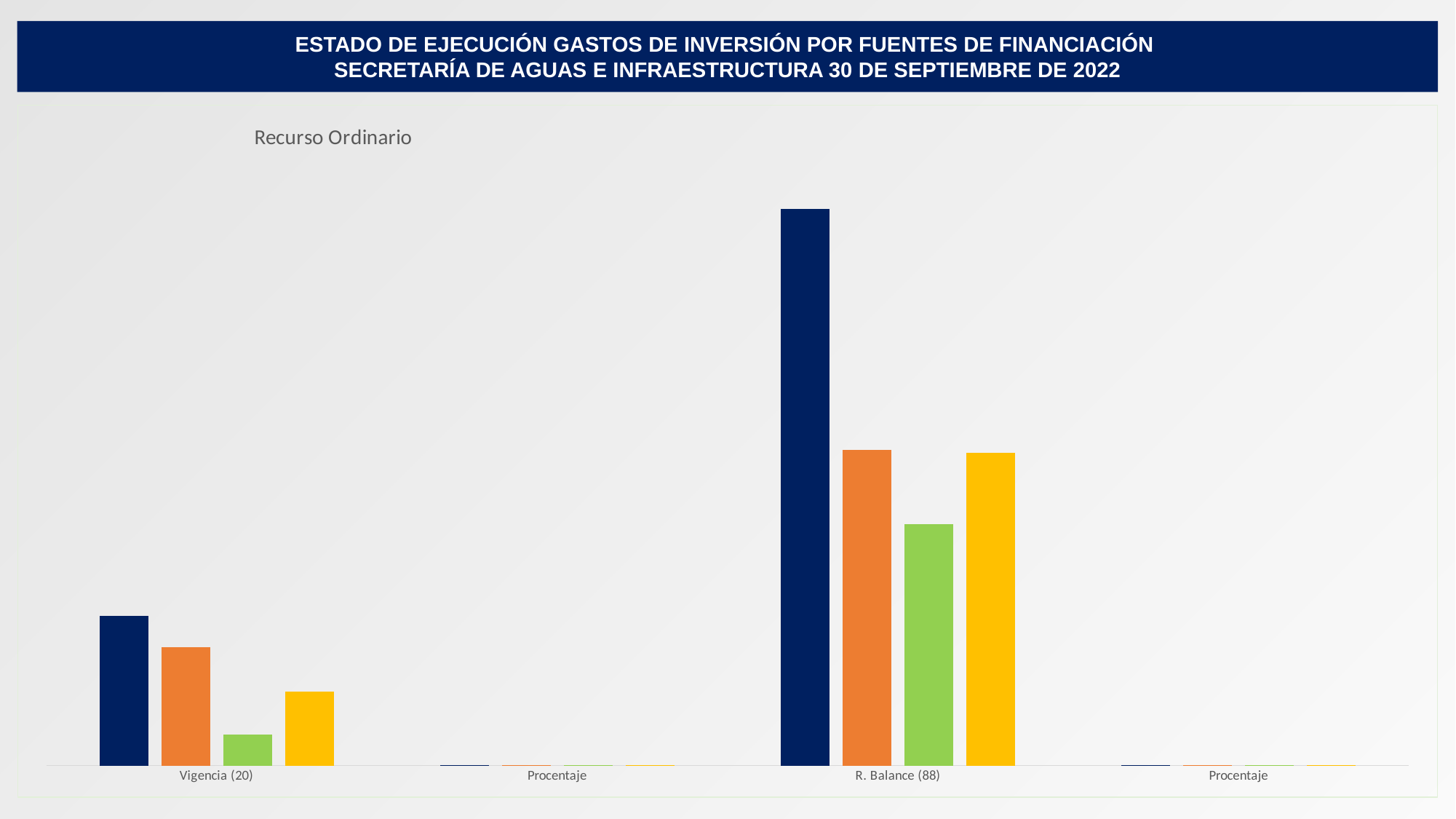
Which colour bar is the tallest within the R. Balance (88) category? dark blue Which colour bar is the tallest within the Vigencia (20) category? dark blue Which two categories show essentially no visible bars? Procentaje (both) How many bars are plotted for the category R. Balance (88)? 4 What is the title of the chart? Recurso Ordinario Within the Vigencia (20) category, is the orange bar or the yellow bar larger? orange Which colour bar is the shortest within the R. Balance (88) category? green How many categories are shown along the x axis of the chart? 4 What kind of chart is shown on the slide? bar chart Which category has the tallest bar in the chart? R. Balance (88) Which colour bar is the shortest within the Vigencia (20) category? green Is the dark blue bar larger for Vigencia (20) or for R. Balance (88)? R. Balance (88)